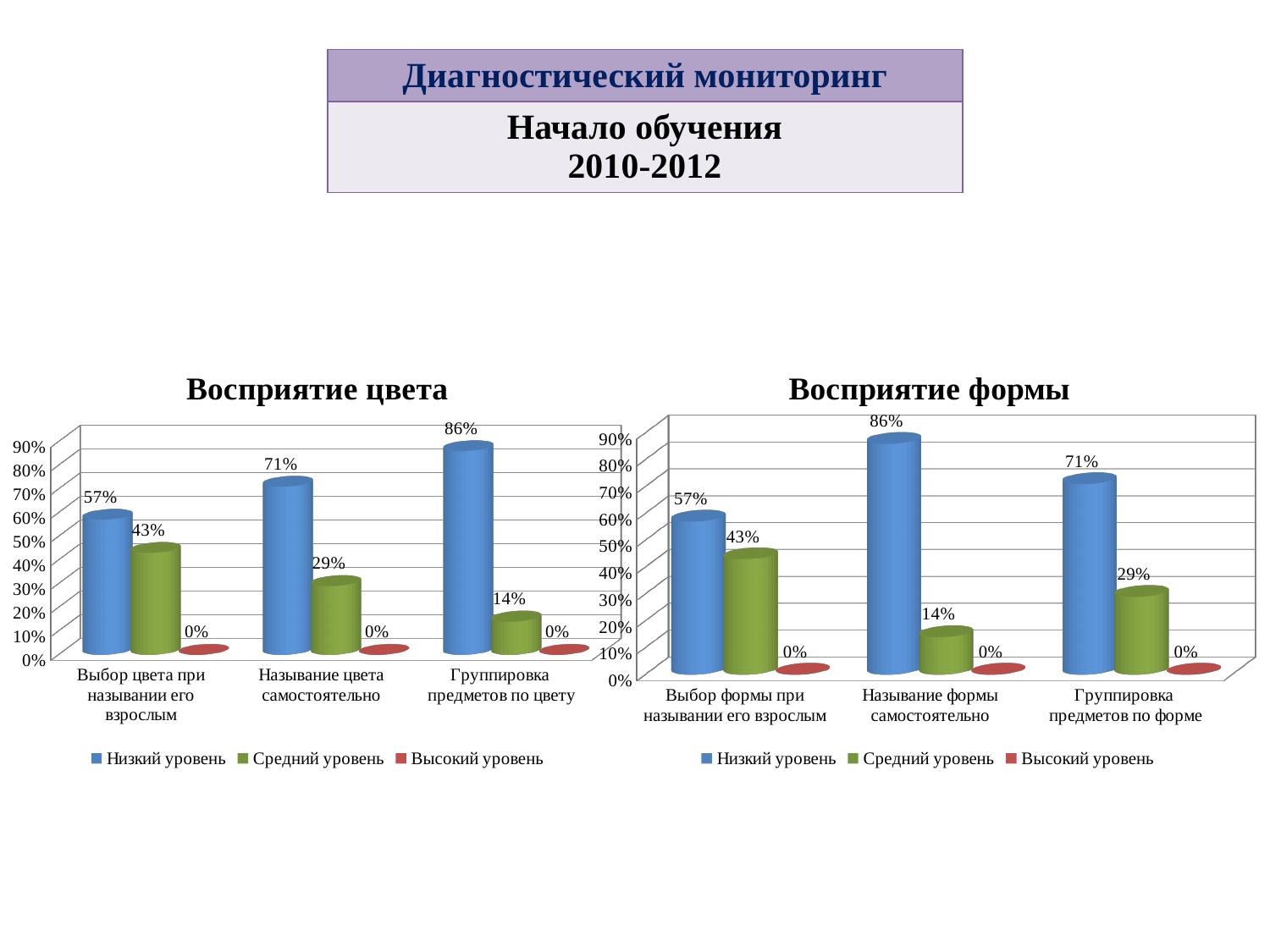
In the 'Восприятие формы' chart, what is the value of 'Средний уровень' for 'Группировка предметов по форме'? 29% How many series does the legend of the 'Восприятие цвета' chart list? 3 In the 'Восприятие цвета' chart, which category has the highest 'Низкий уровень' value? Группировка предметов по цвету In the 'Восприятие формы' chart, which is larger: 'Низкий уровень' for 'Выбор формы при назывании его взрослым' or 'Низкий уровень' for 'Группировка предметов по форме'? Группировка предметов по форме In the 'Восприятие цвета' chart, what is the value of 'Высокий уровень' for every category? 0% In the 'Восприятие формы' chart, which category has the lowest 'Средний уровень' value? Называние формы самостоятельно What type of chart is 'Восприятие цвета'? Bar chart In the 'Восприятие цвета' chart, what is the difference between the 'Низкий уровень' and 'Средний уровень' values for 'Выбор цвета при назывании его взрослым'? 14% How many categories are shown in the 'Восприятие формы' chart? 3 In the 'Восприятие цвета' chart, what is the value of 'Низкий уровень' for 'Группировка предметов по цвету'? 86% In the 'Восприятие формы' chart, what is the value of 'Низкий уровень' for 'Называние формы самостоятельно'? 86% In the 'Восприятие цвета' chart, what is the value of 'Средний уровень' for 'Называние цвета самостоятельно'? 29%